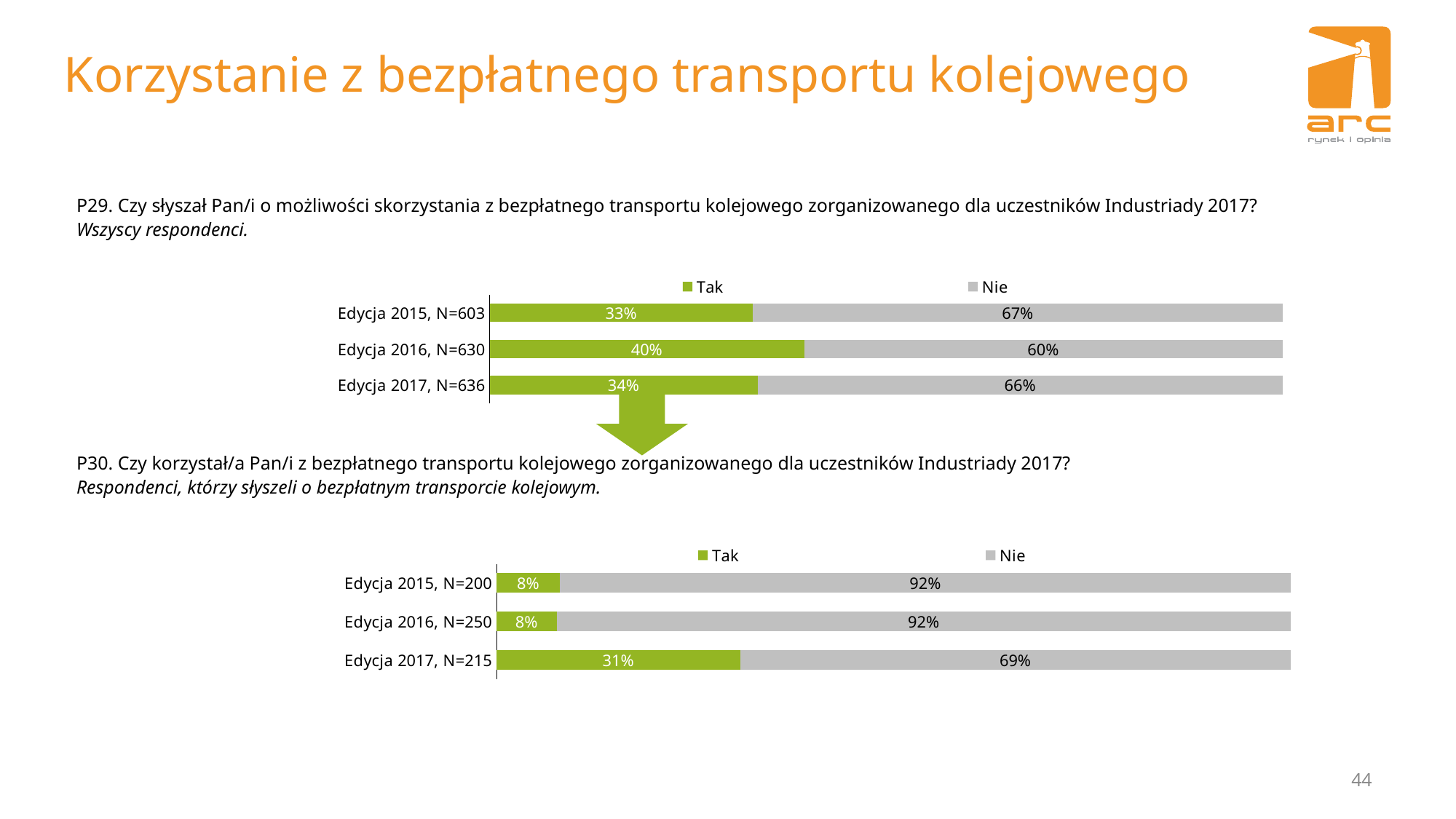
In the bottom chart (P30), which edition has the lowest 'Nie' share? Edycja 2017, N=215 In the top chart (P29), what is the 'Nie' value for Edycja 2015, N=603? 67% What type of chart is the bottom chart (P30)? Stacked bar chart In the top chart (P29), which edition has the highest 'Tak' share? Edycja 2016, N=630 In the top chart (P29), what is the difference between the 'Tak' values for Edycja 2016 and Edycja 2015? 7 percentage points In the top chart (P29), what is the total of the stacked bar for Edycja 2017, N=636? 100% In the bottom chart (P30), what is the 'Nie' value for Edycja 2016, N=250? 92% In the bottom chart (P30), what is the difference between the 'Tak' values for Edycja 2017 and Edycja 2015? 23 percentage points How many series does the legend of the top chart (P29) list? 2 In the bottom chart (P30), what is the 'Tak' value for Edycja 2017, N=215? 31% In the bottom chart (P30), is the 'Tak' value for Edycja 2017 larger or smaller than the 'Tak' value for Edycja 2016? larger In the top chart (P29), what is the 'Tak' value for Edycja 2016, N=630? 40%